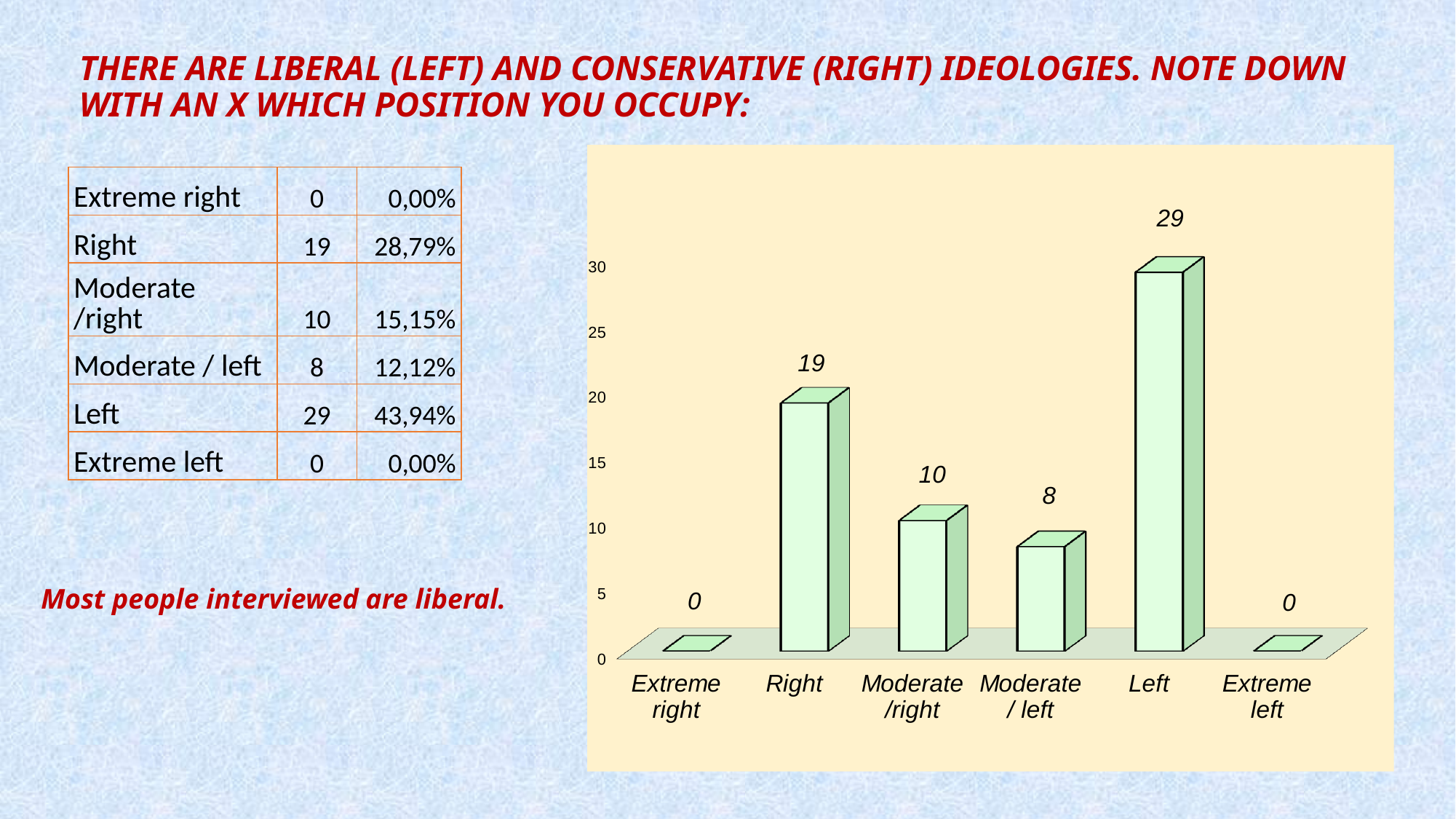
How many categories have a value of 0? 2 What is the highest tick value shown on the vertical axis? 30 What is the value for Moderate /right? 10 What is the difference between the values for Left and Right? 10 Which is larger, the value for Moderate /right or the value for Moderate / left? Moderate /right What is the value for Left? 29 Which category has the highest value? Left What is the value for Right? 19 Is the value for Right greater or less than 15? greater How many categories are shown on the x axis? 6 What is the total of the values for Right and Moderate /right? 29 What kind of chart is shown? bar chart